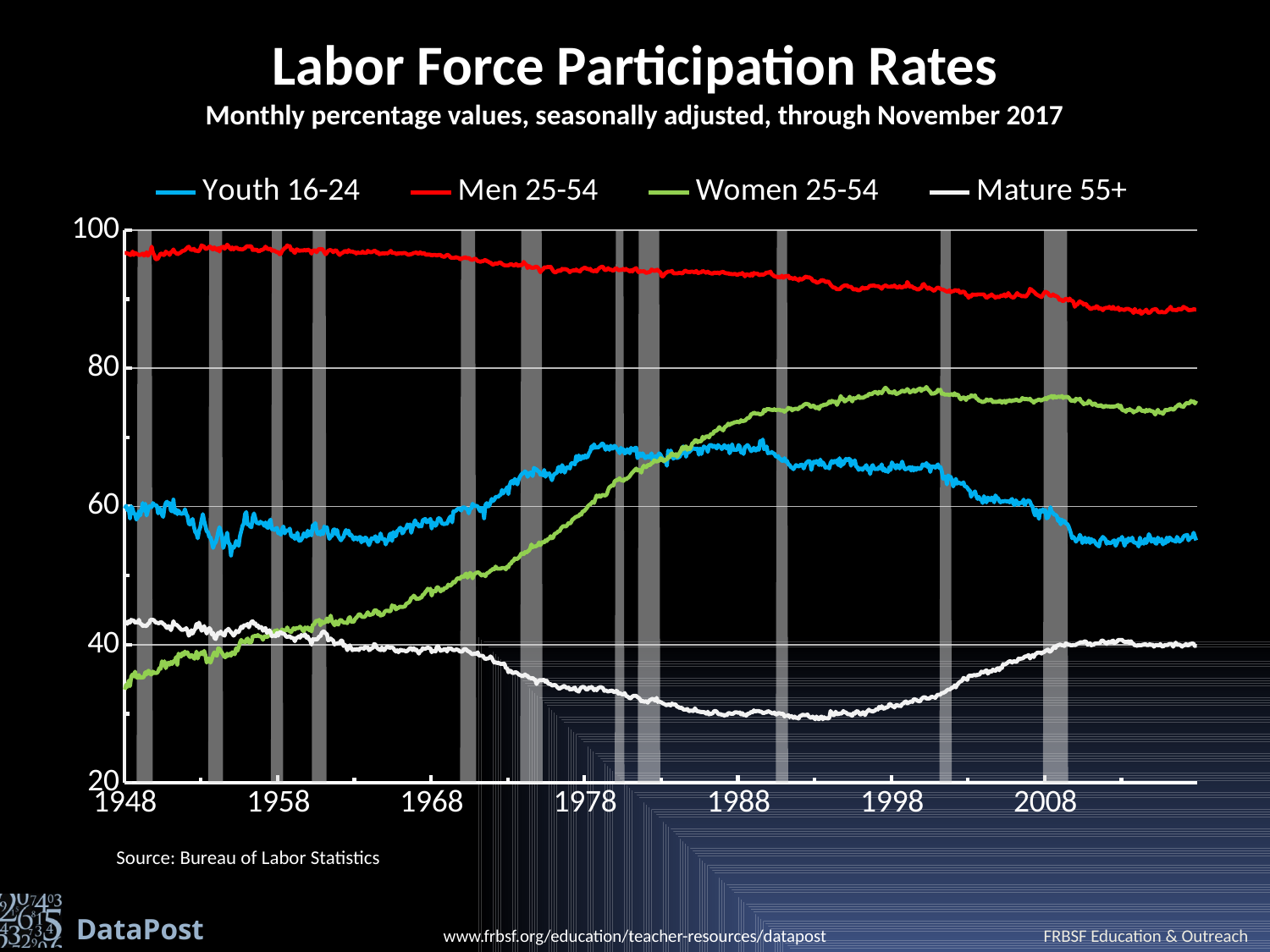
Is the value for Mature 55+ in 1998 greater or less than 40? less Does the Women 25-54 series rise or fall overall from 1948 to 2017? rise Is the value for Women 25-54 in 1948 greater or less than 40? less Which series has the highest labor force participation rate across the whole period? Men 25-54 What kind of chart is shown on the slide? line chart Is the value for Men 25-54 in 1948 greater or less than 80? greater Which series has the lowest value in 1948? Women 25-54 What is the title of the chart? Labor Force Participation Rates Does the Men 25-54 series rise or fall overall from 1948 to 2017? fall Which series has the lowest value in 2008? Mature 55+ In 2008, which is larger: the value for Women 25-54 or the value for Youth 16-24? Women 25-54 How many series does the legend list? 4